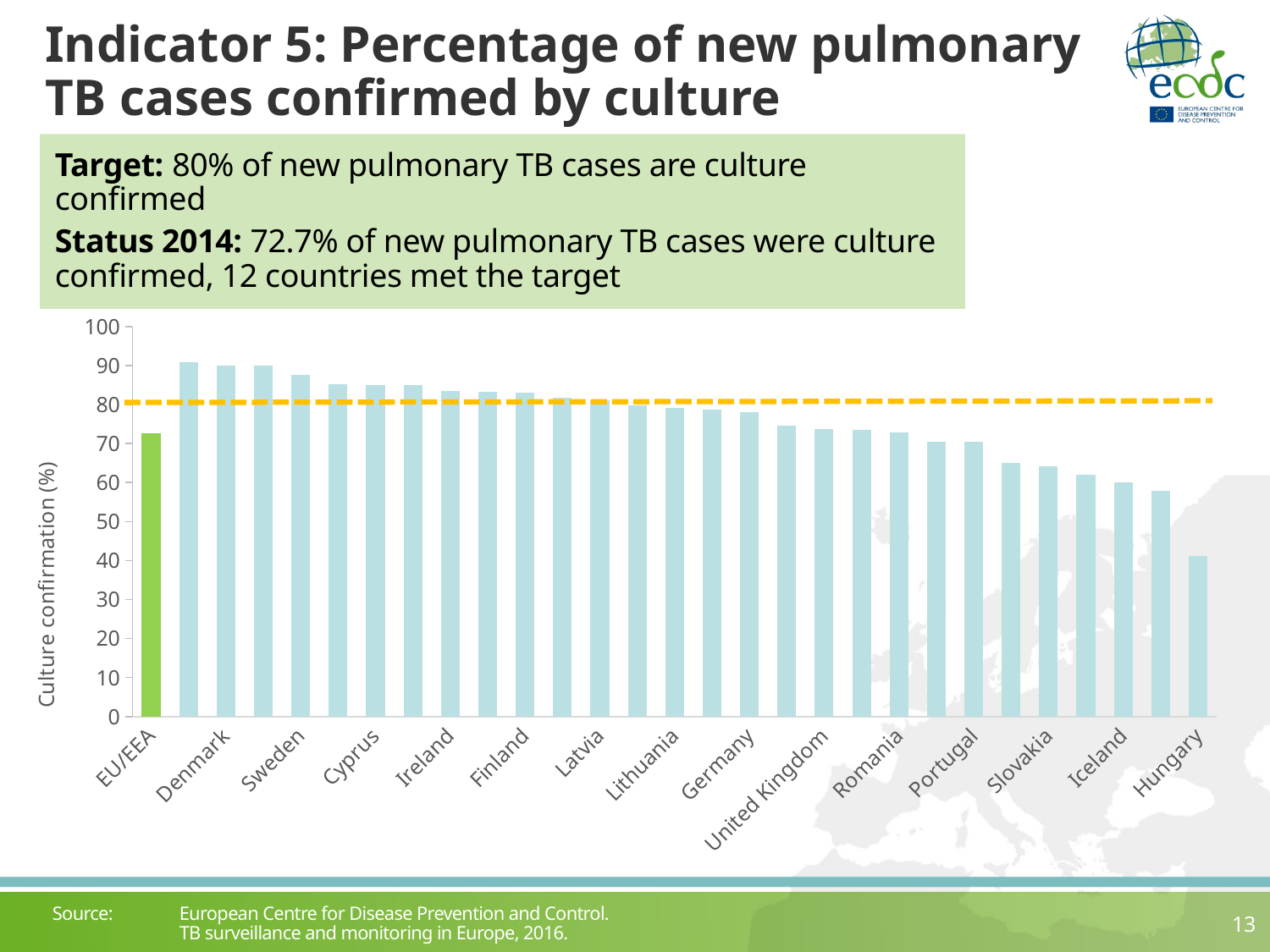
What is the label of the y axis? Culture confirmation (%) Is the value for Denmark greater or less than 80? greater Which has a higher culture confirmation percentage, Hungary or Cyprus? Cyprus Which country has the lowest culture confirmation percentage? Hungary Is the value for Romania greater or less than 70? greater What kind of chart is shown on the slide? bar chart Is the value for Hungary greater or less than 50? less What is the culture confirmation value for EU/EEA? 72.7% Which has a higher culture confirmation percentage, Sweden or Iceland? Sweden Do the country values rise or fall from left to right along the x axis? fall